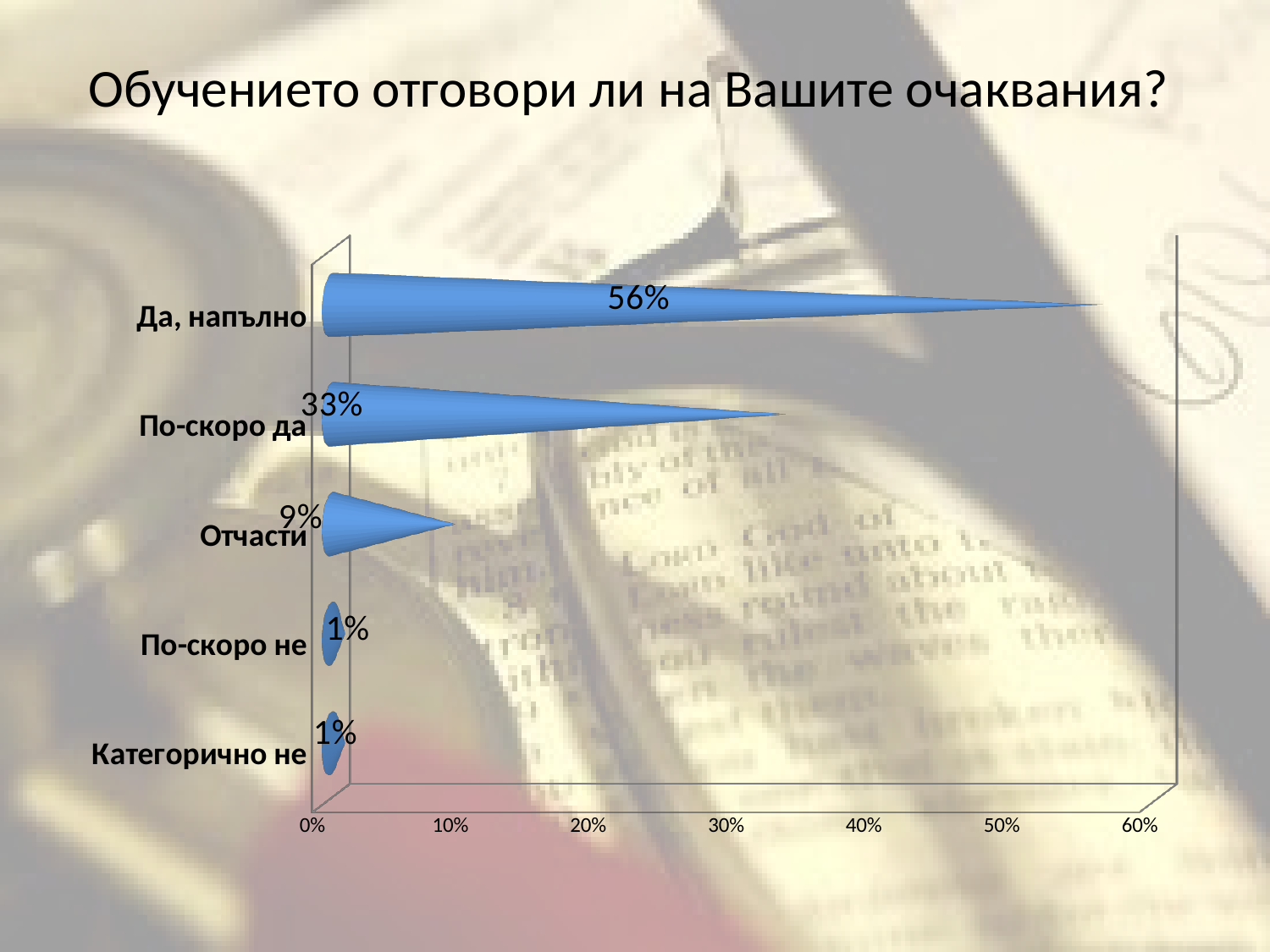
Is the value for "Да, напълно" greater or less than 50%? greater What kind of chart is shown on the slide? bar chart What is the difference between the values for "По-скоро да" and "Отчасти"? 24% What is the value for "По-скоро да"? 33% Which is larger, the value for "Отчасти" or the value for "По-скоро не"? Отчасти How many categories are shown in the chart? 5 What is the value for "Да, напълно"? 56% What is the title of the slide? Обучението отговори ли на Вашите очаквания? What is the difference between the values for "Да, напълно" and "По-скоро да"? 23% What is the value for "По-скоро не"? 1% What is the value for "Отчасти"? 9% Which category has the highest value? Да, напълно